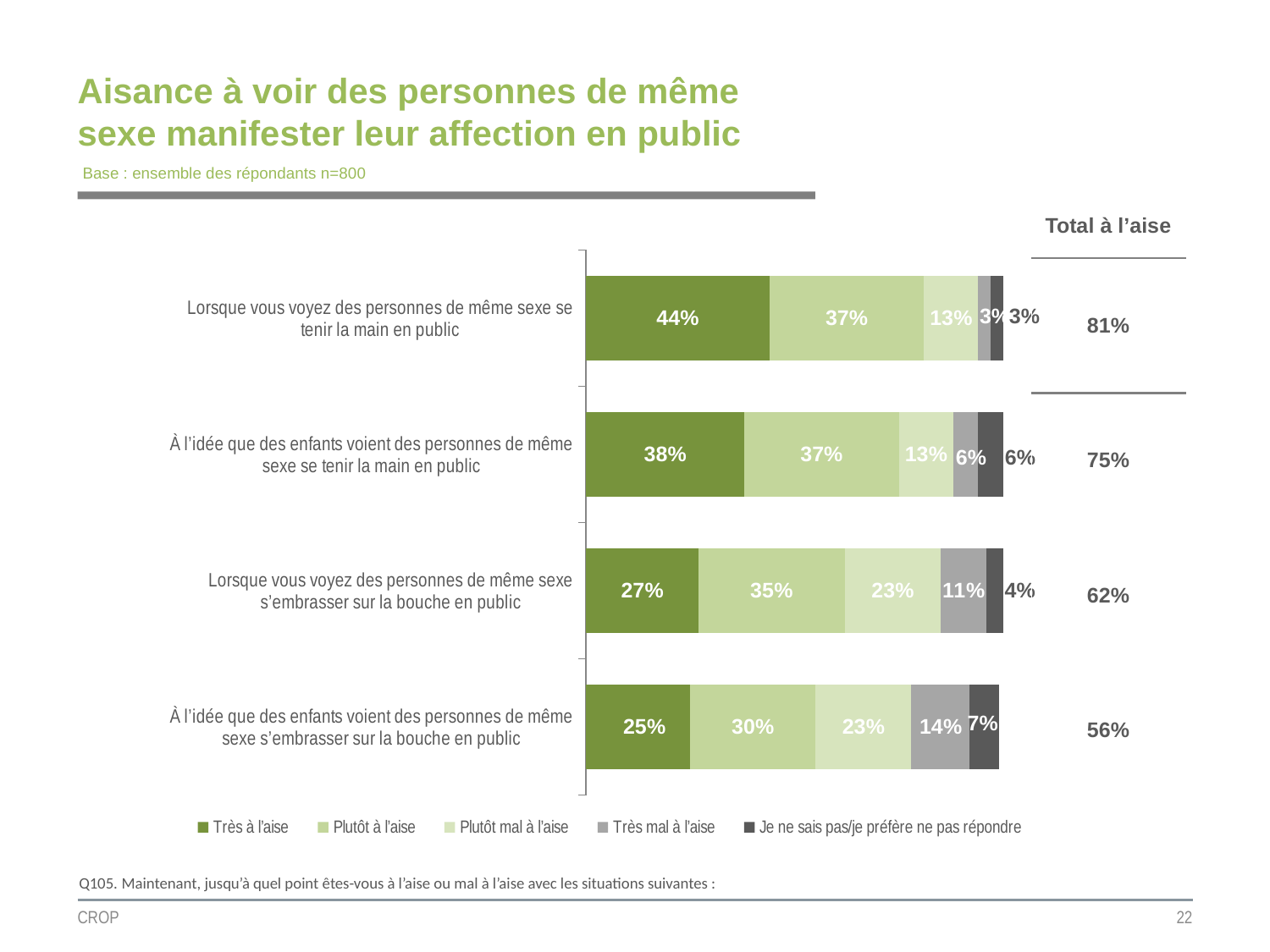
What is the 'Plutôt mal à l'aise' value for 'Lorsque vous voyez des personnes de même sexe s'embrasser sur la bouche en public'? 23% Which has the larger 'Très mal à l'aise' value: 'Lorsque vous voyez des personnes de même sexe s'embrasser sur la bouche en public' or 'À l'idée que des enfants voient des personnes de même sexe s'embrasser sur la bouche en public'? À l'idée que des enfants voient des personnes de même sexe s'embrasser sur la bouche en public What kind of chart is shown on the slide? Stacked bar chart Which situation has the highest 'Très à l'aise' value? Lorsque vous voyez des personnes de même sexe se tenir la main en public Which situation has the lowest 'Total à l'aise' value? À l'idée que des enfants voient des personnes de même sexe s'embrasser sur la bouche en public What is the difference in 'Très à l'aise' between 'Lorsque vous voyez des personnes de même sexe se tenir la main en public' and 'À l'idée que des enfants voient des personnes de même sexe s'embrasser sur la bouche en public'? 19 percentage points What is the base (number of respondents) stated under the chart title? n=800 What is the 'Très à l'aise' value for 'Lorsque vous voyez des personnes de même sexe se tenir la main en public'? 44% What is the 'Je ne sais pas/je préfère ne pas répondre' value for 'À l'idée que des enfants voient des personnes de même sexe se tenir la main en public'? 6% What is the 'Total à l'aise' value for 'À l'idée que des enfants voient des personnes de même sexe s'embrasser sur la bouche en public'? 56% How many situations (categories) are plotted in the chart? 4 How many series does the legend list? 5